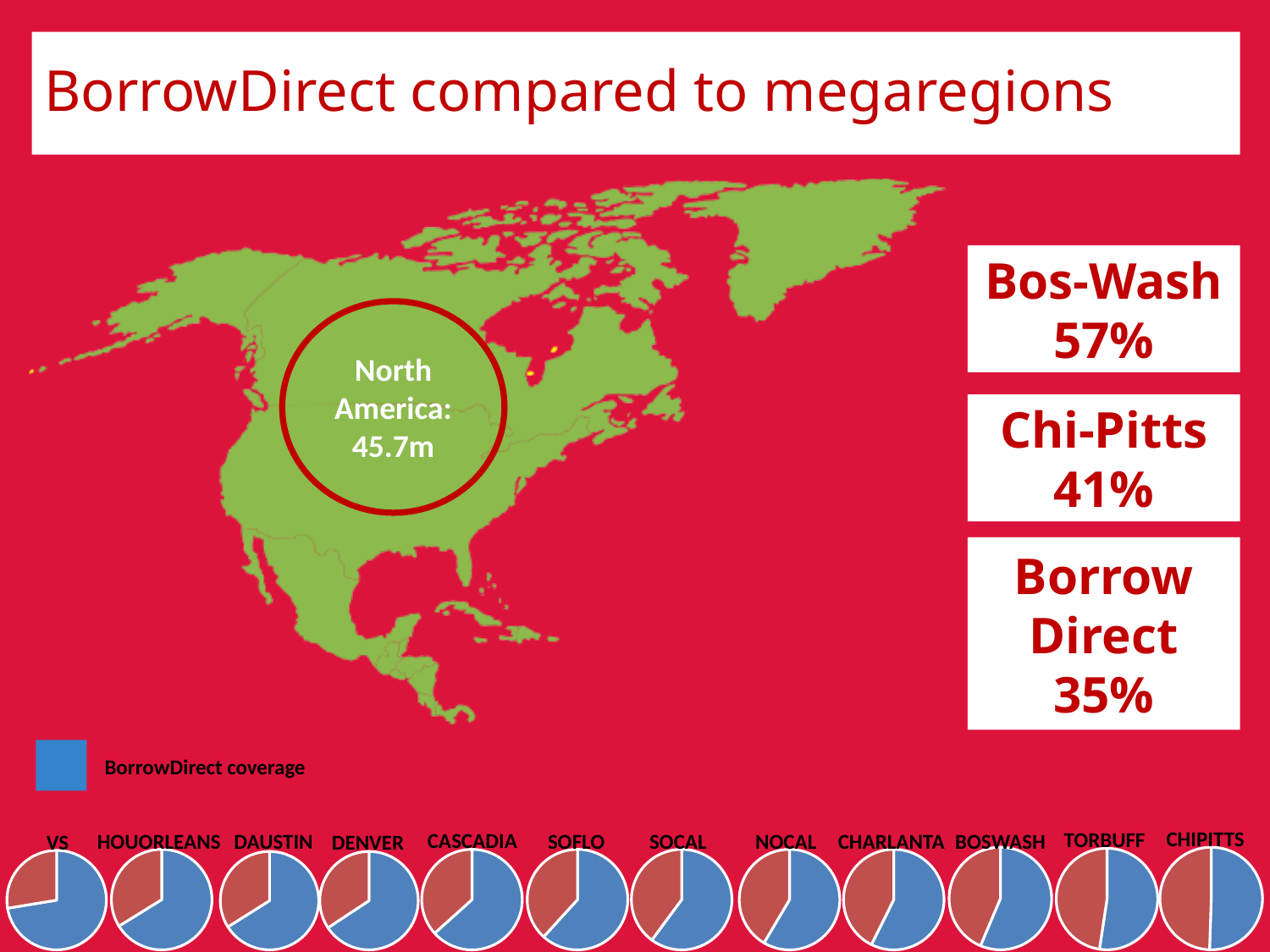
What is the label of the first pie chart on the left of the bottom row? VS What kind of charts are shown along the bottom of the slide? Pie charts What does the blue colour in the pie charts represent, according to the legend? BorrowDirect coverage Which pie chart has a larger blue (BorrowDirect coverage) share, VS or HOUORLEANS? VS Which pie chart has a larger blue (BorrowDirect coverage) share, VS or CHIPITTS? VS How many pie charts are shown along the bottom of the slide? 12